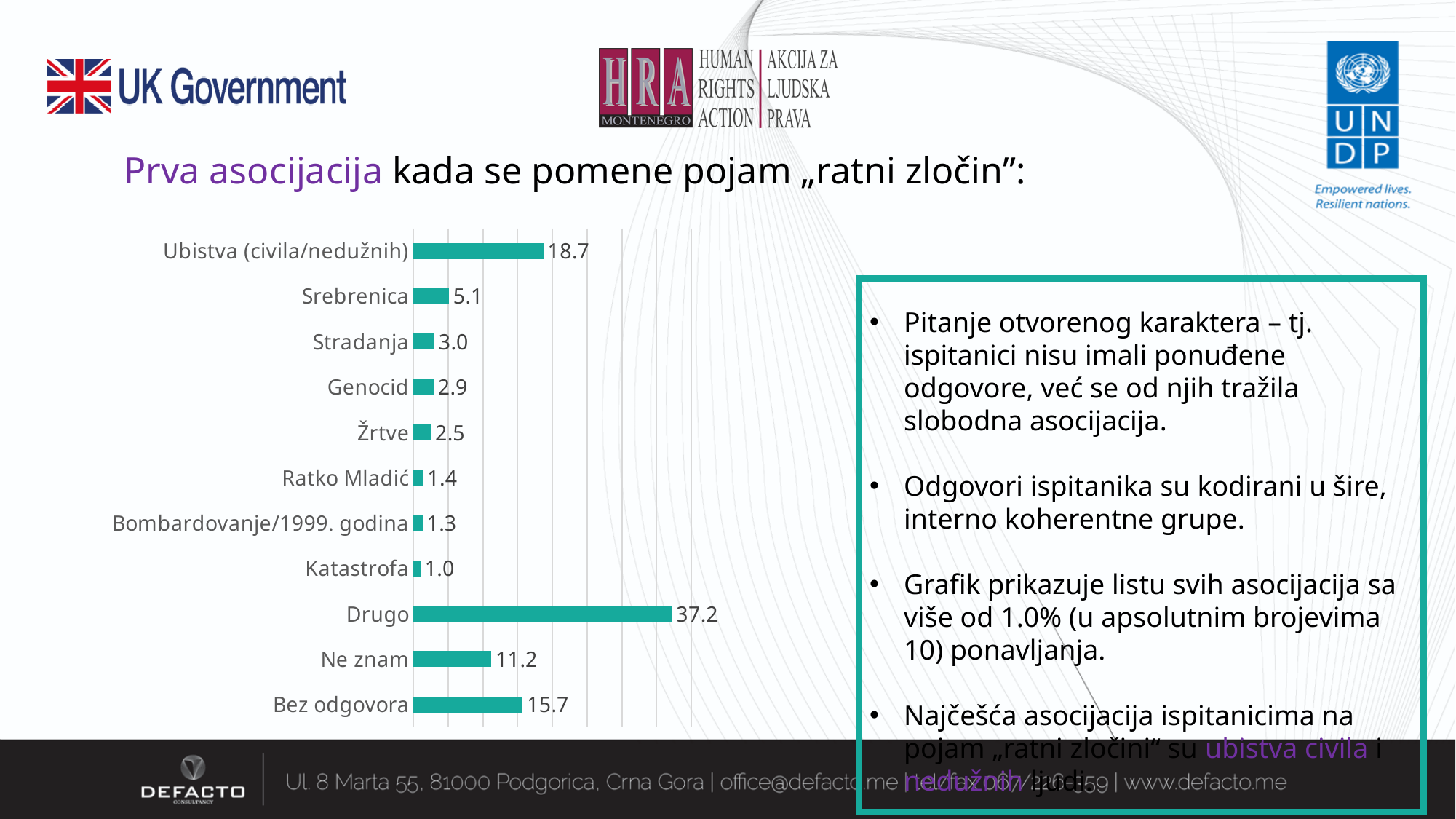
Which category has the highest value? Drugo What is the difference between the values for Bez odgovora and Ne znam? 4.5 What is the difference between the values for Drugo and Ubistva (civila/nedužnih)? 18.5 What is the value for Bombardovanje/1999. godina? 1.3 What is the value for Ubistva (civila/nedužnih)? 18.7 What is the value for Ne znam? 11.2 Which category has the lowest value? Katastrofa What is the value for Srebrenica? 5.1 Which is larger, the value for Stradanja or the value for Genocid? Stradanja What kind of chart is shown on the slide? Bar chart How many categories are shown in the chart? 11 What is the value for Žrtve? 2.5